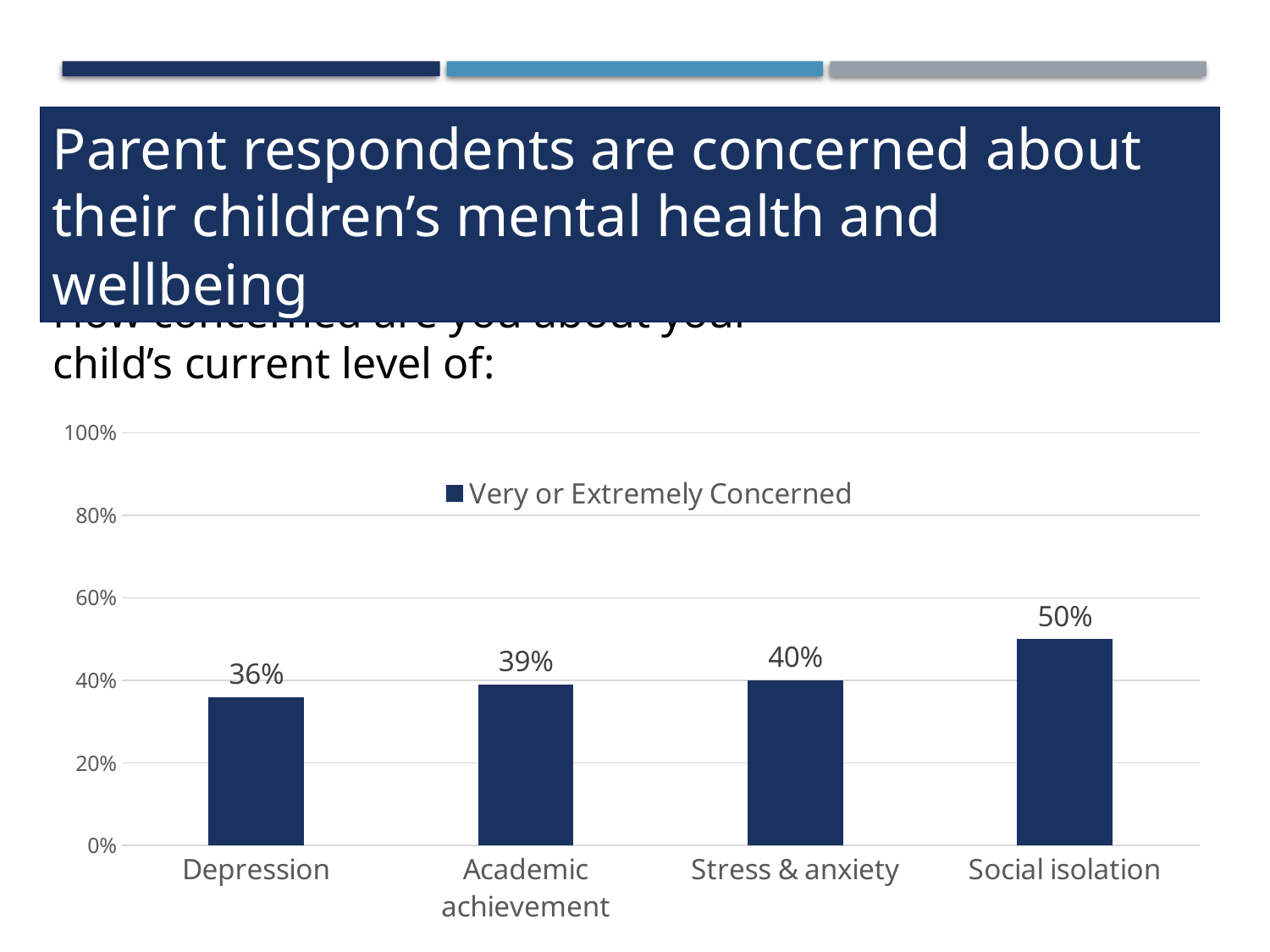
Is the value for Social isolation greater or less than 40%? greater What is the value for Stress & anxiety? 40% Which category has the lowest percentage of very or extremely concerned parents? Depression What is the value for Academic achievement? 39% Which category has the highest percentage of very or extremely concerned parents? Social isolation Which is larger, the value for Stress & anxiety or the value for Depression? Stress & anxiety What is the value for Social isolation? 50% How many categories are shown on the x axis of the chart? 4 What percentage of parent respondents are very or extremely concerned about their child's depression? 36% What kind of chart is shown on the slide? Bar chart What series does the chart legend list? Very or Extremely Concerned What is the difference between the values for Social isolation and Depression? 14%